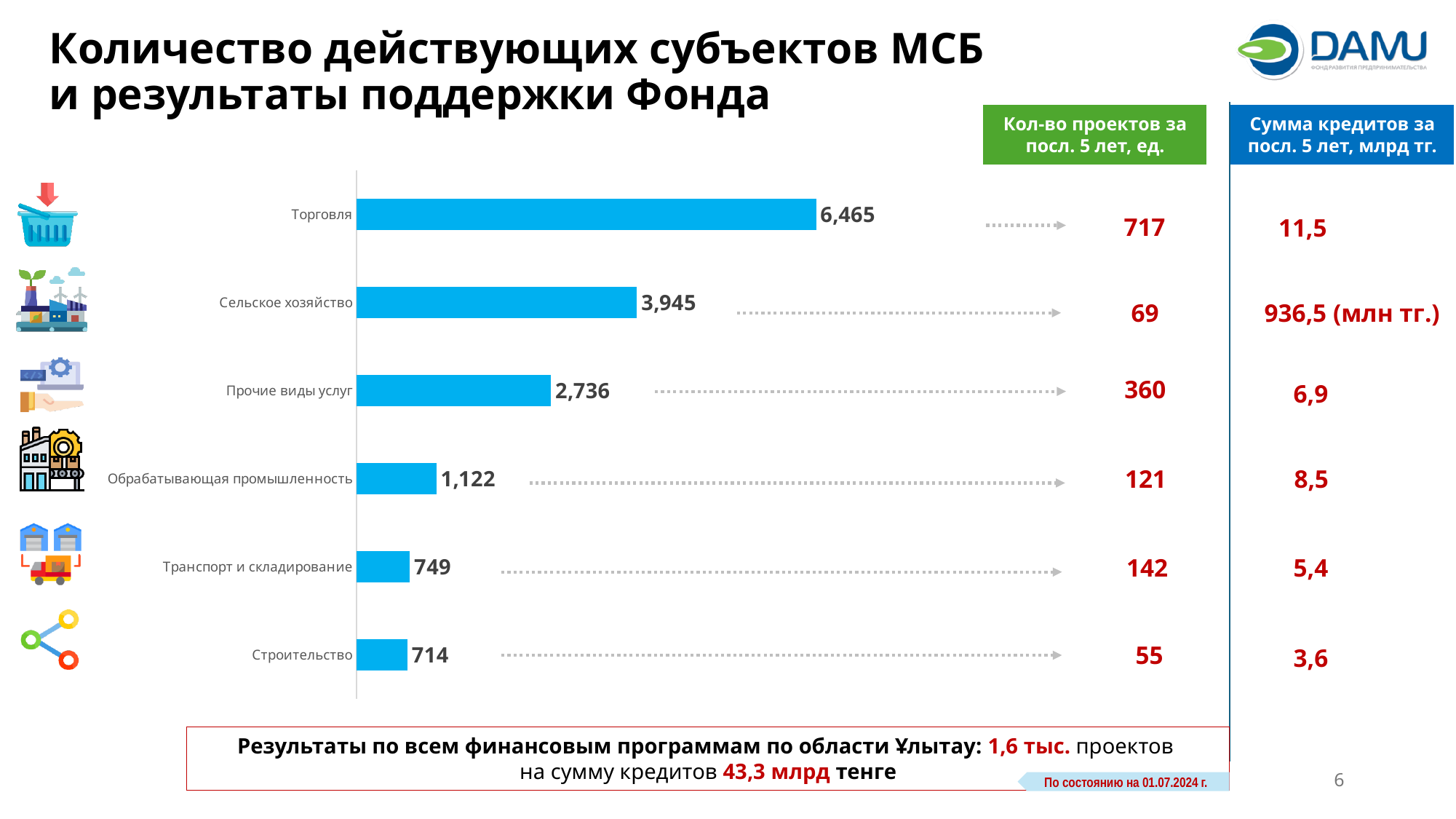
Which is larger in the bar chart: Прочие виды услуг or Обрабатывающая промышленность? Прочие виды услуг What is the value for Сельское хозяйство in the bar chart? 3,945 What is the value for Строительство in the bar chart? 714 What is the difference between the values for Транспорт и складирование and Строительство? 35 What colour are the bars in the chart? blue What is the value for Торговля in the bar chart? 6,465 What is the value for Обрабатывающая промышленность in the bar chart? 1,122 What kind of chart is shown on the slide? bar chart Which category has the lowest value in the bar chart? Строительство What is the difference between the values for Торговля and Сельское хозяйство? 2,520 How many categories does the bar chart show? 6 Which category has the highest value in the bar chart? Торговля